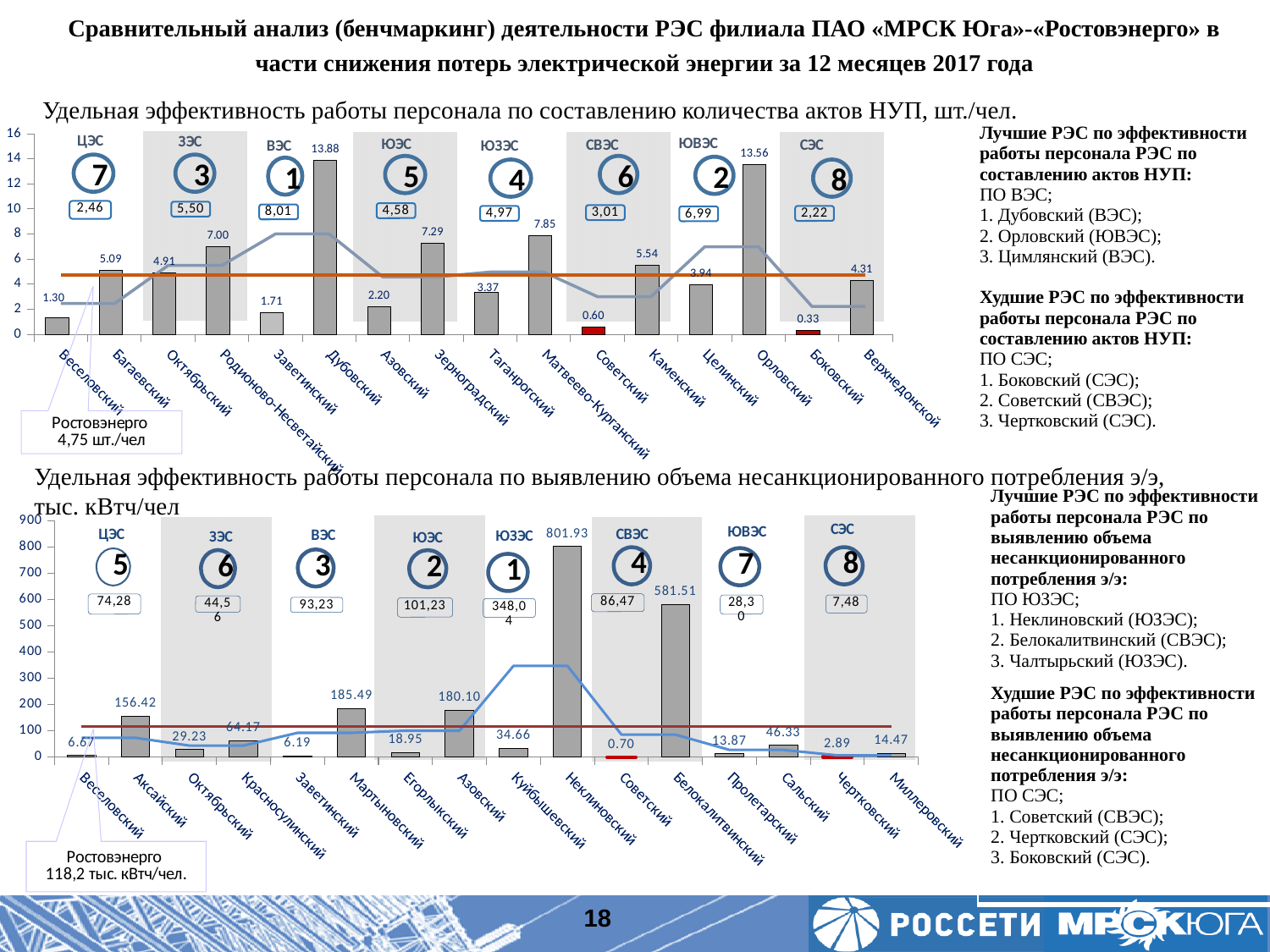
In the top chart (acts НУП per person), which is larger: Зерноградский or Матвеево-Курганский? Матвеево-Курганский In the top chart (acts НУП per person), what is the value for Дубовский? 13.88 In the bottom chart (unauthorized consumption volume per person), is the value for Мартыновский greater or less than 100? greater In the top chart (acts НУП per person), what is the Ростовэнерго average shown in the callout? 4,75 шт./чел In the bottom chart (unauthorized consumption volume per person), which category has the lowest value? Советский In the bottom chart (unauthorized consumption volume per person), what is the difference between Неклиновский and Белокалитвинский? 220.42 In the top chart (acts НУП per person), what is the difference between Орловский and Каменский? 8.02 In the top chart (acts НУП per person), which category has the highest value? Дубовский In the bottom chart (unauthorized consumption volume per person), what is the value for Неклиновский? 801.93 What kind of chart is the top chart on the slide? Combination bar and line chart In the top chart (acts НУП per person), which category has the lowest value? Боковский In the bottom chart (unauthorized consumption volume per person), how many categories are plotted on the x axis? 16